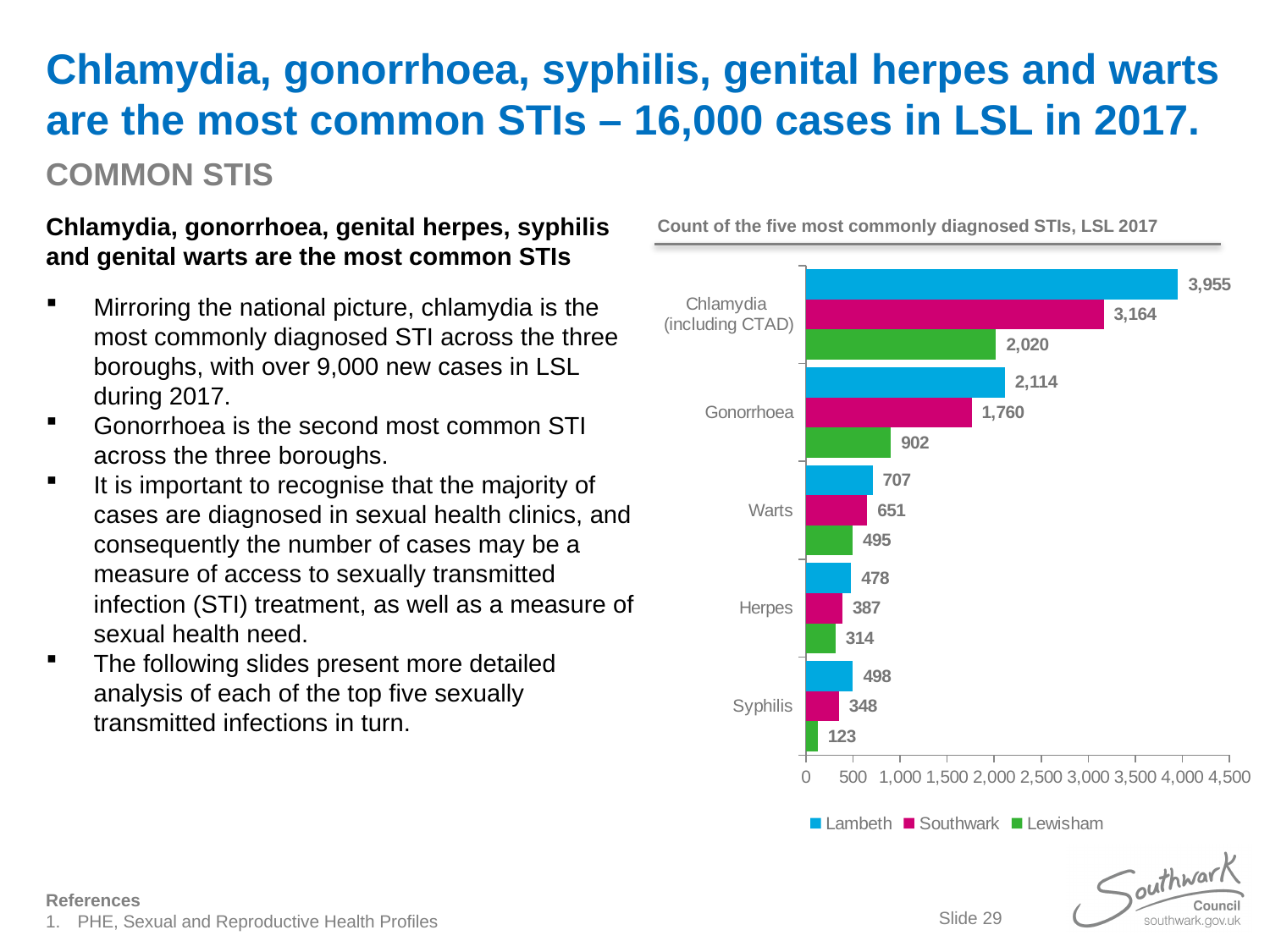
Which borough has a higher count of herpes cases, Southwark or Lewisham? Southwark What is the title of the chart? Count of the five most commonly diagnosed STIs, LSL 2017 How many STI categories are shown on the chart? 5 What is the count of syphilis cases for Lewisham? 123 Which STI has the highest count for Lambeth? Chlamydia (including CTAD) Which STI has the lowest count for Lewisham? Syphilis What kind of chart is shown on the slide? Bar chart What is the count of chlamydia (including CTAD) cases for Lambeth? 3,955 How many series does the legend list? 3 What is the count of gonorrhoea cases for Southwark? 1,760 What is the difference between the Lambeth and Southwark counts for chlamydia (including CTAD)? 791 What is the count of warts cases for Lambeth? 707